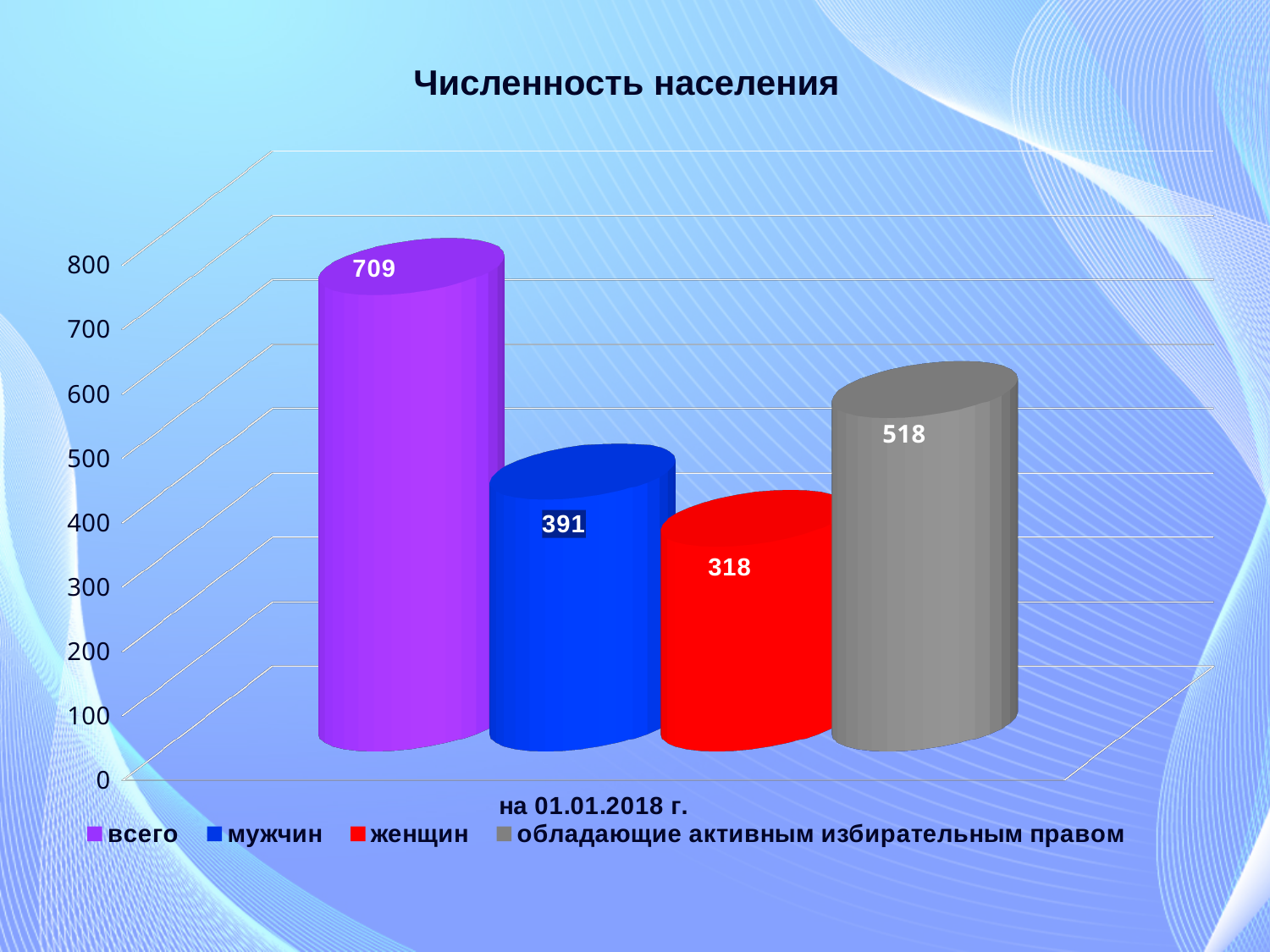
What is the difference between the values for "всего" and "обладающие активным избирательным правом"? 191 What is the value for "всего"? 709 Which series has the highest value? всего What is the title of the chart? Численность населения What is the difference between the values for "мужчин" and "женщин"? 73 What is the value for "женщин"? 318 What is the value for "обладающие активным избирательным правом"? 518 Which series has the lowest value? женщин What kind of chart is shown on the slide? bar chart What is the value for "мужчин"? 391 How many series does the legend list? 4 Which is larger, the value for "мужчин" or the value for "обладающие активным избирательным правом"? обладающие активным избирательным правом